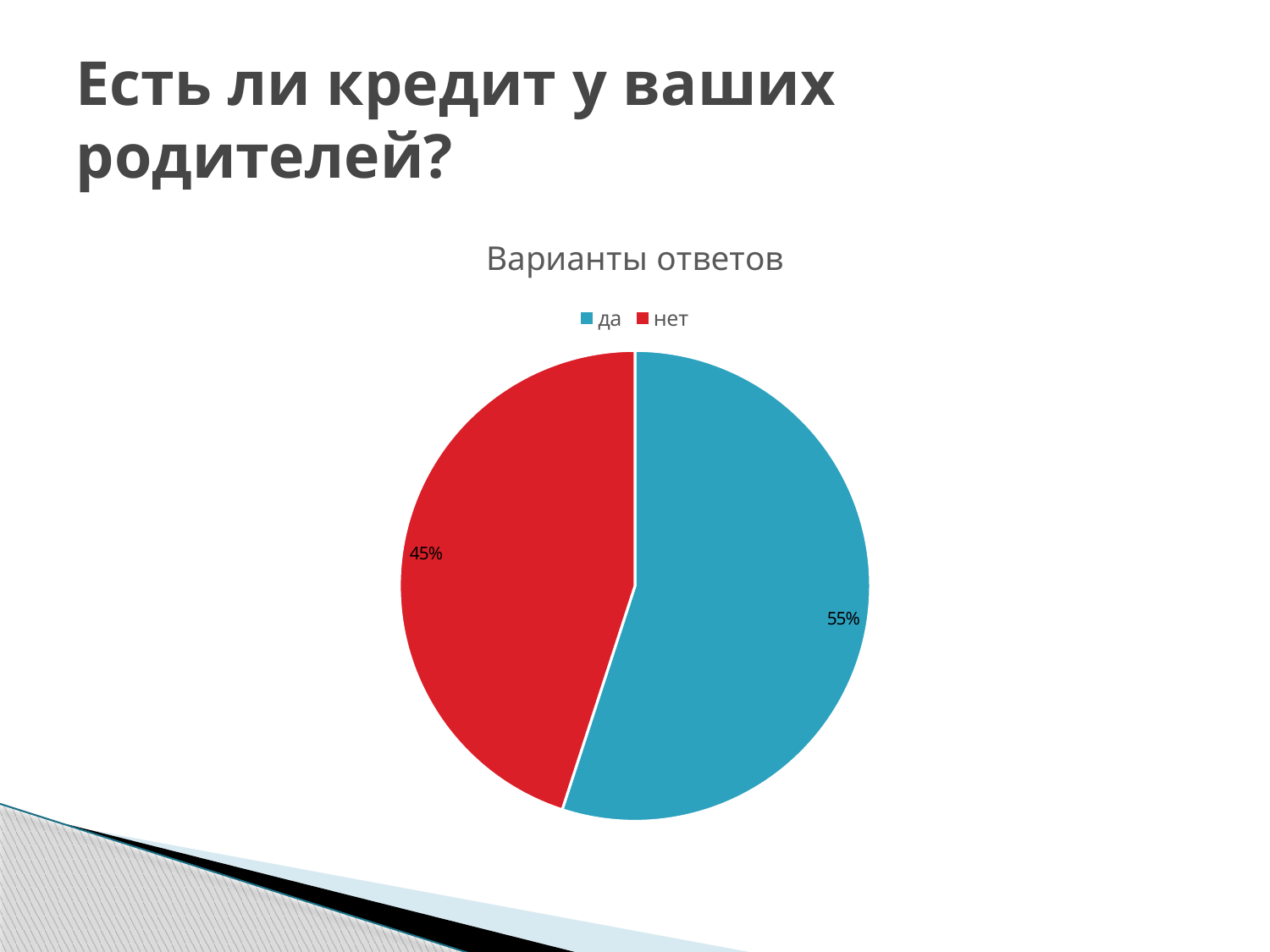
What share of the pie is the "да" slice? 55% Which slice is the smallest? нет Which slice is the largest? да What is the difference in percentage points between the "да" and "нет" slices? 10% What is the chart's title? Варианты ответов What kind of chart is shown on the slide? pie chart Which is larger, the "да" slice or the "нет" slice? да How many entries does the legend list? 2 Is the share for "да" greater or less than 50%? greater What share of the pie is the "нет" slice? 45% What colour is the "нет" slice? red How many slices does the pie chart have? 2